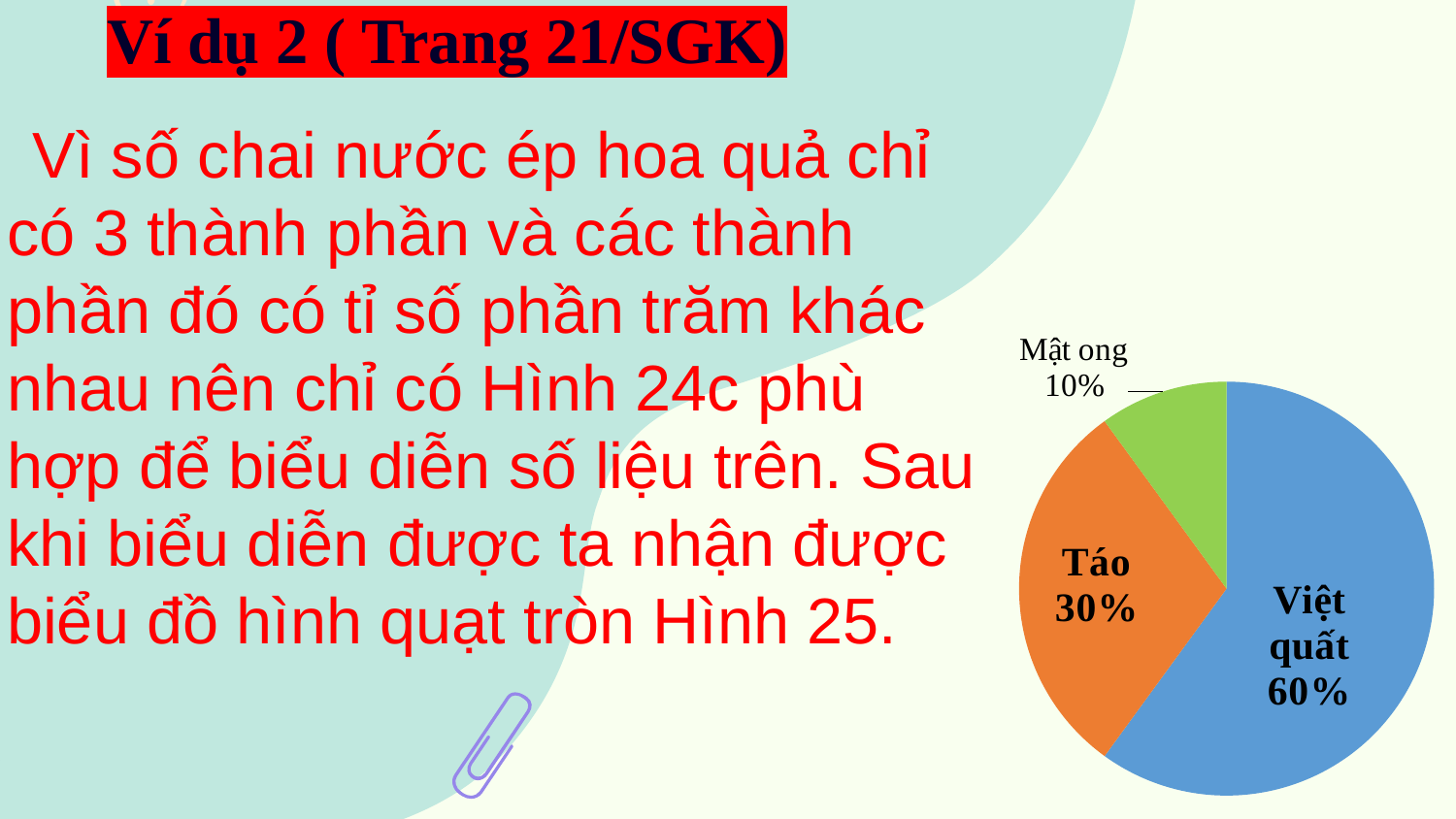
What is the difference in percentage between Táo and Mật ong? 20% Which slice of the pie chart is the largest? Việt quất What kind of chart is shown on the slide? pie chart What colour is the Việt quất slice? blue What percentage does the Táo slice represent? 30% What percentage does the Mật ong slice represent? 10% Which is larger, the Táo slice or the Mật ong slice? Táo What colour is the Mật ong slice? green How many slices does the pie chart have? 3 What is the difference in percentage between Việt quất and Táo? 30% Which slice of the pie chart is the smallest? Mật ong What percentage does the Việt quất slice represent? 60%